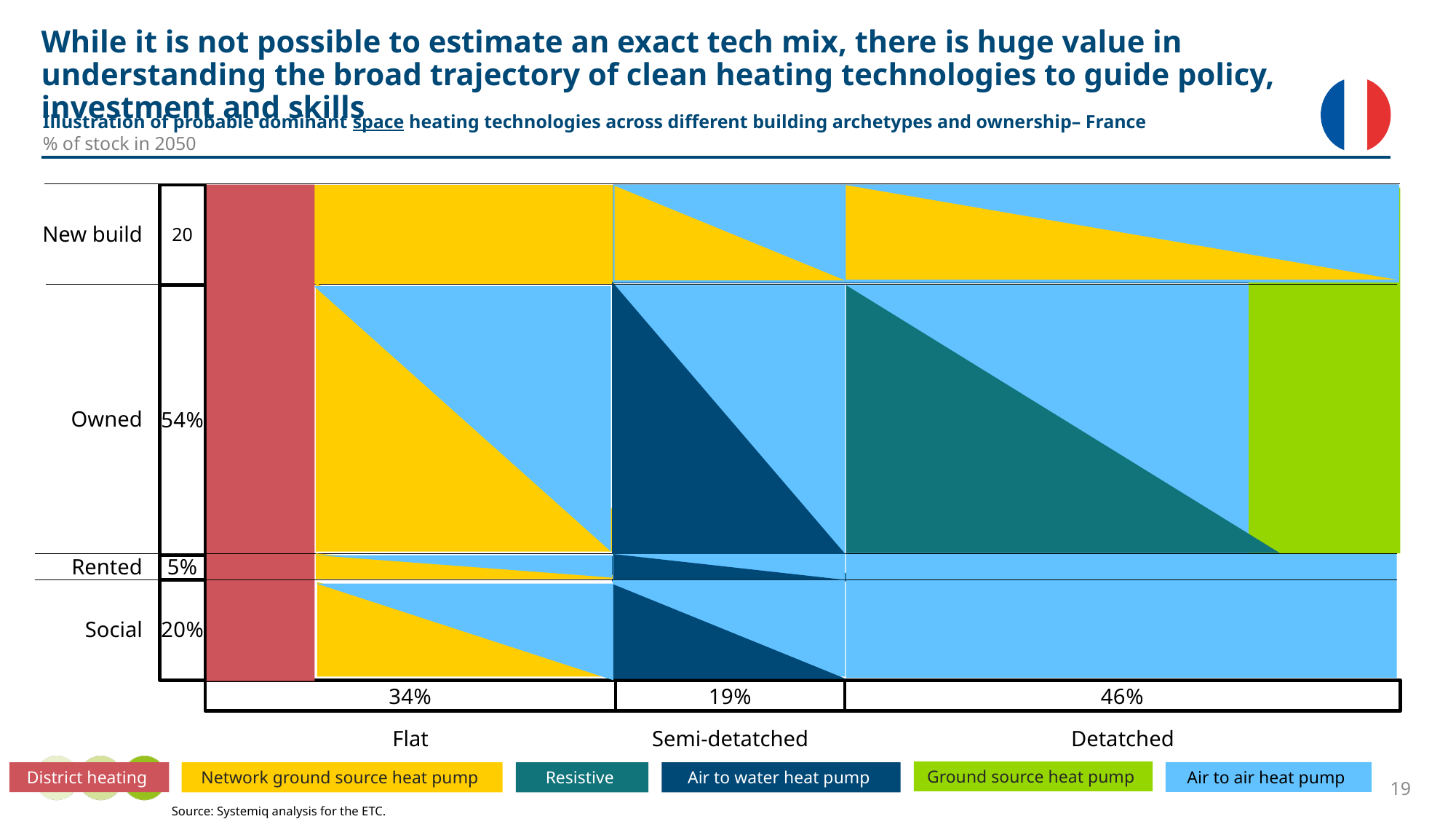
How many building archetypes are shown along the bottom of the chart? 3 What is the difference in share of stock between Detatched and Flat? 12% What value is printed next to the New build row? 20 Which building archetype has the smallest share of stock in 2050? Semi-detatched Which ownership category has the smallest share of stock? Rented Which building archetype has the largest share of stock in 2050? Detatched What percentage of stock is shown for the Owned ownership category? 54% What percentage of stock in 2050 is shown for the Flat building archetype? 34% Which heating technology is shown in yellow in the legend? Network ground source heat pump How many heating technologies does the legend list? 6 What percentage of stock in 2050 is shown for the Detatched building archetype? 46% Which has a larger share of stock, Owned or Social? Owned